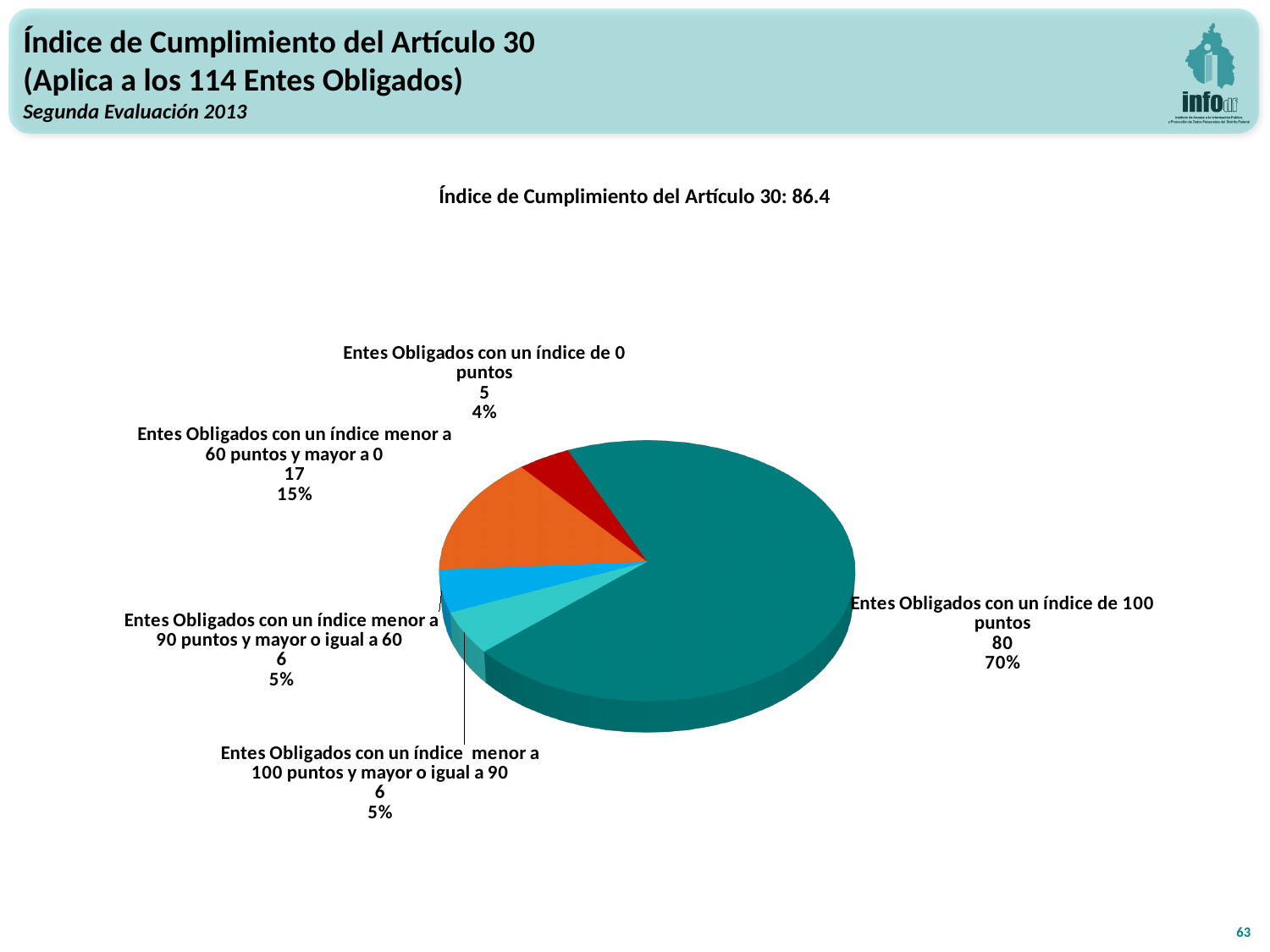
Which category has the largest slice of the pie? Entes Obligados con un índice de 100 puntos What kind of chart is shown on the slide? pie chart What percentage of the pie is Entes Obligados con un índice menor a 60 puntos y mayor a 0? 15% What share of the pie corresponds to Entes Obligados con un índice de 100 puntos? 70% How many categories does the pie chart have? 5 What is the difference between the number of Entes Obligados with an índice de 100 puntos and those with an índice menor a 60 puntos y mayor a 0? 63 What is the Índice de Cumplimiento del Artículo 30 stated above the chart? 86.4 What is the total number of Entes Obligados across all slices of the pie? 114 How many Entes Obligados have an índice de 100 puntos? 80 Which is larger: the number of Entes Obligados con un índice de 0 puntos or the number con un índice menor a 90 puntos y mayor o igual a 60? Entes Obligados con un índice menor a 90 puntos y mayor o igual a 60 How many Entes Obligados have an índice de 0 puntos? 5 Which category has the smallest slice of the pie? Entes Obligados con un índice de 0 puntos